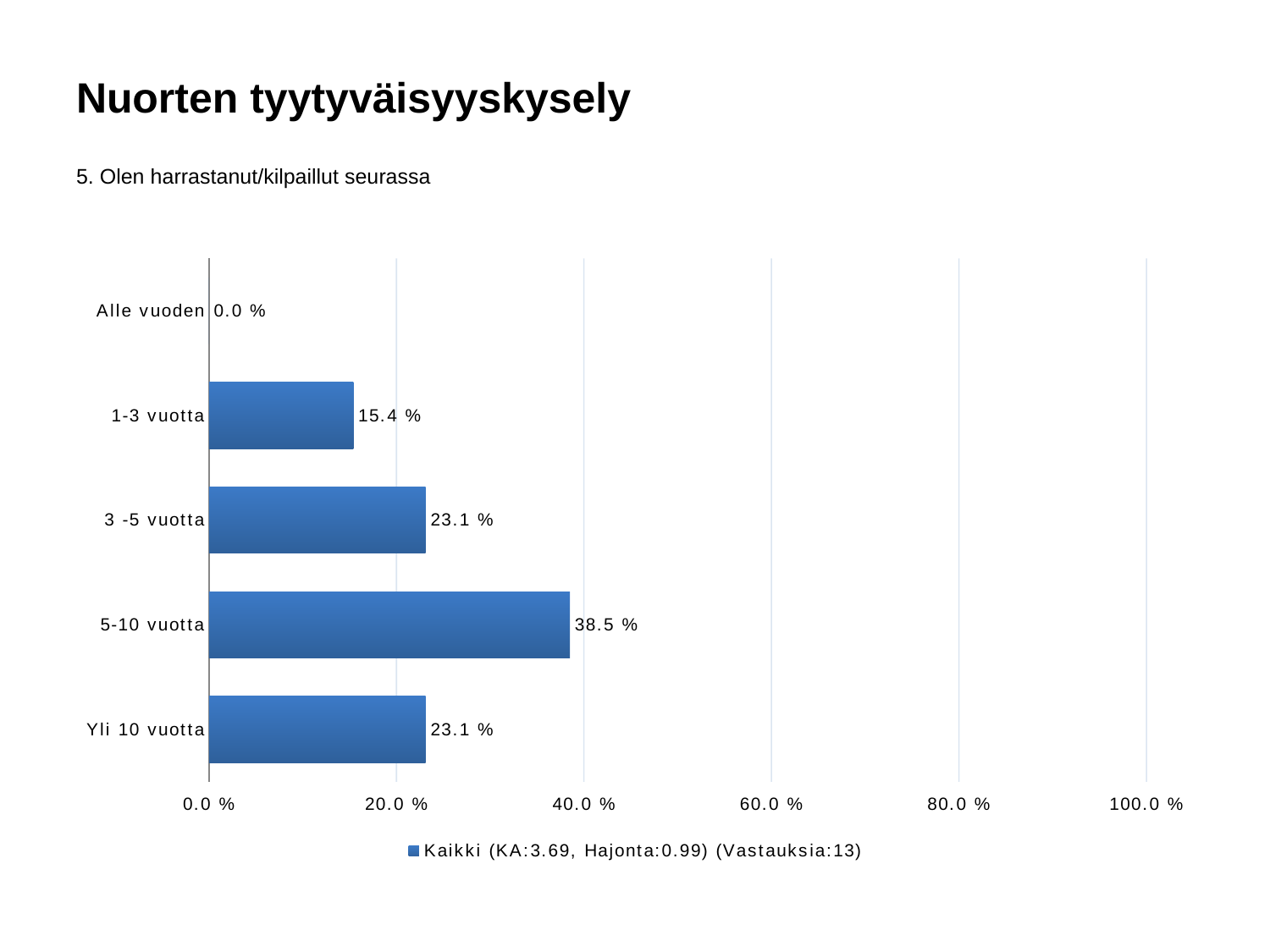
Which category has the lowest value? Alle vuoden What is the value for Alle vuoden? 0.0 % What is the difference between the values for 3 -5 vuotta and 1-3 vuotta? 7.7 % Which is larger, the value for 5-10 vuotta or the value for Yli 10 vuotta? 5-10 vuotta What is the value for 5-10 vuotta? 38.5 % Which category has the highest value? 5-10 vuotta What kind of chart is shown on the slide? bar chart How many responses (Vastauksia) does the legend report? 13 How many categories are shown in the chart? 5 What is the value for 1-3 vuotta? 15.4 % Is the value for 5-10 vuotta greater or less than 40.0 %? less What is the difference between the values for 5-10 vuotta and 1-3 vuotta? 23.1 %